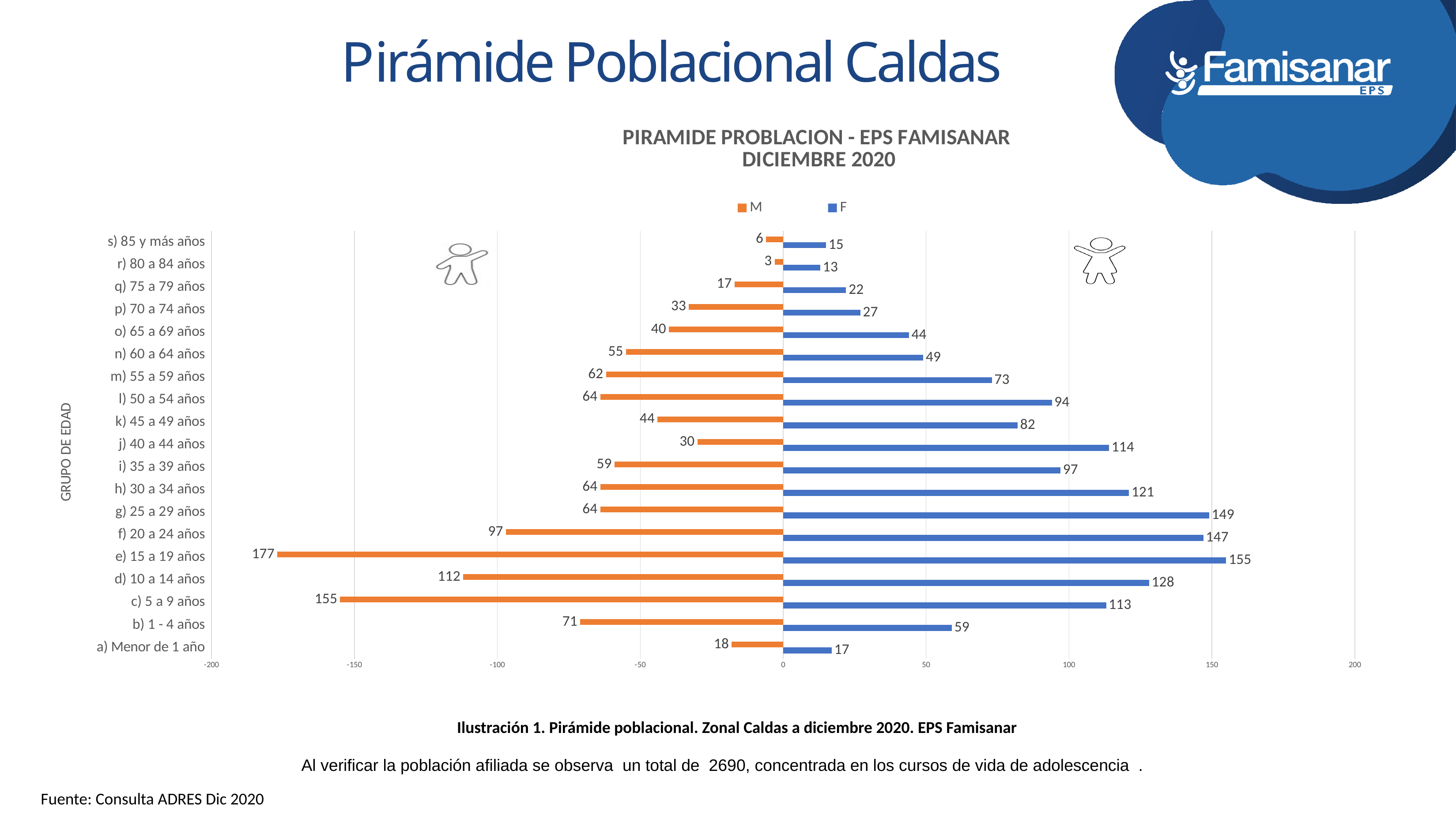
What is the difference between the F and M values in the age group c) 5 a 9 años? 42 What is the value for F in the age group j) 40 a 44 años? 114 Which age group has the lowest value for the M series? r) 80 a 84 años What is the value for F in the age group g) 25 a 29 años? 149 What is the value for M in the age group e) 15 a 19 años? 177 Which age group has the highest value for the F series? e) 15 a 19 años How many series does the legend list? 2 What kind of chart is shown on the slide? Bar chart Which age group has the highest value for the M series? e) 15 a 19 años What is the title of the chart? PIRAMIDE PROBLACION - EPS FAMISANAR DICIEMBRE 2020 How many age groups are shown on the chart? 19 In the age group l) 50 a 54 años, which series has the larger value, M or F? F